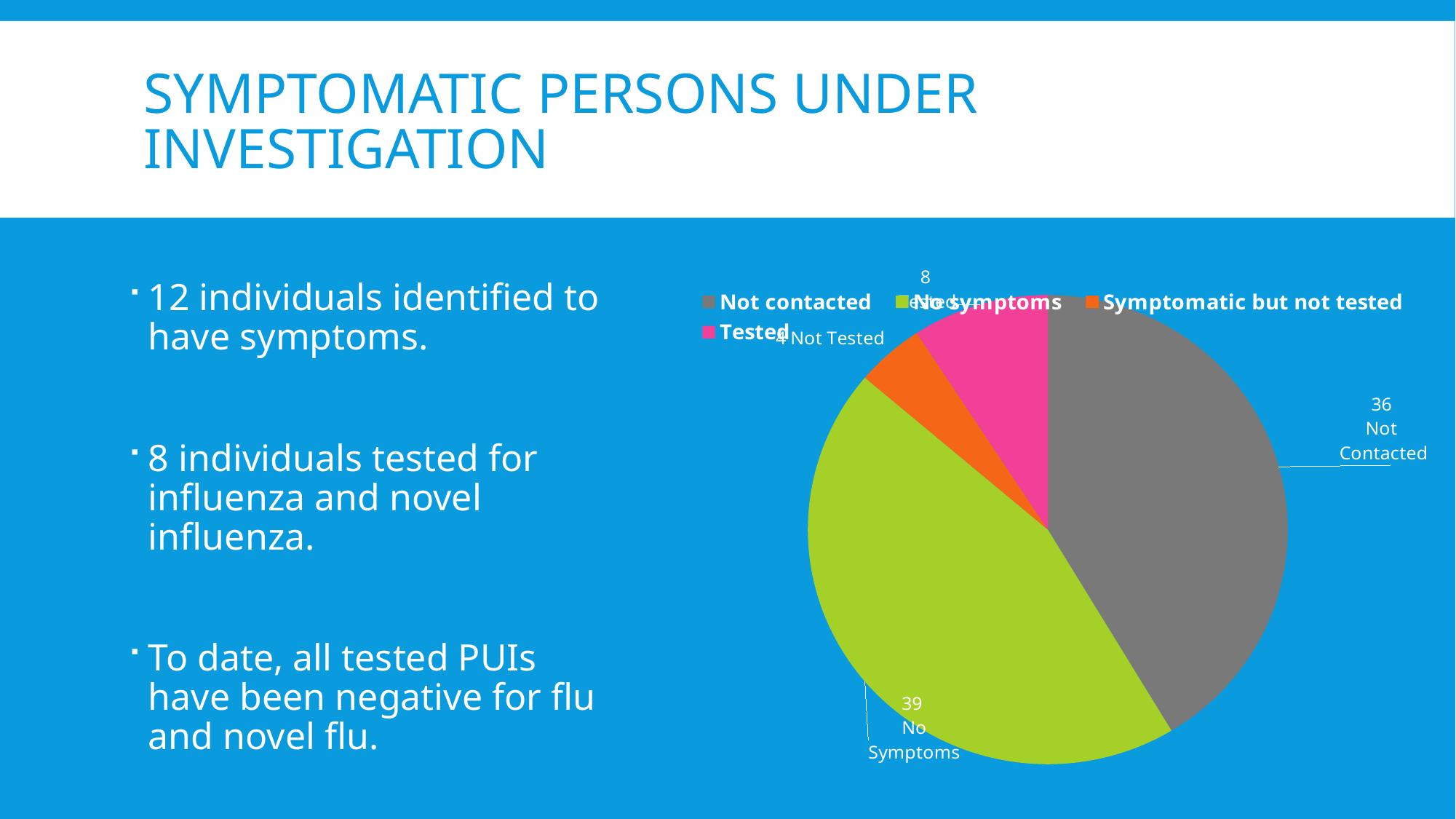
Which category has the smallest slice in the pie chart? Symptomatic but not tested Which category has the largest slice in the pie chart? No Symptoms How many entries does the chart legend list? 4 What value is shown for the Not Contacted slice of the pie chart? 36 What value is shown for the No Symptoms slice of the pie chart? 39 What type of chart is shown on the slide? Pie chart What is the difference between the Tested value and the Not Tested value? 4 How much larger is the No Symptoms value than the Not Contacted value? 3 How many slices does the pie chart have? 4 Which is larger, the Not Contacted slice or the Tested slice? Not Contacted What value is shown for the Tested slice of the pie chart? 8 What value is shown for the Not Tested (symptomatic but not tested) slice of the pie chart? 4